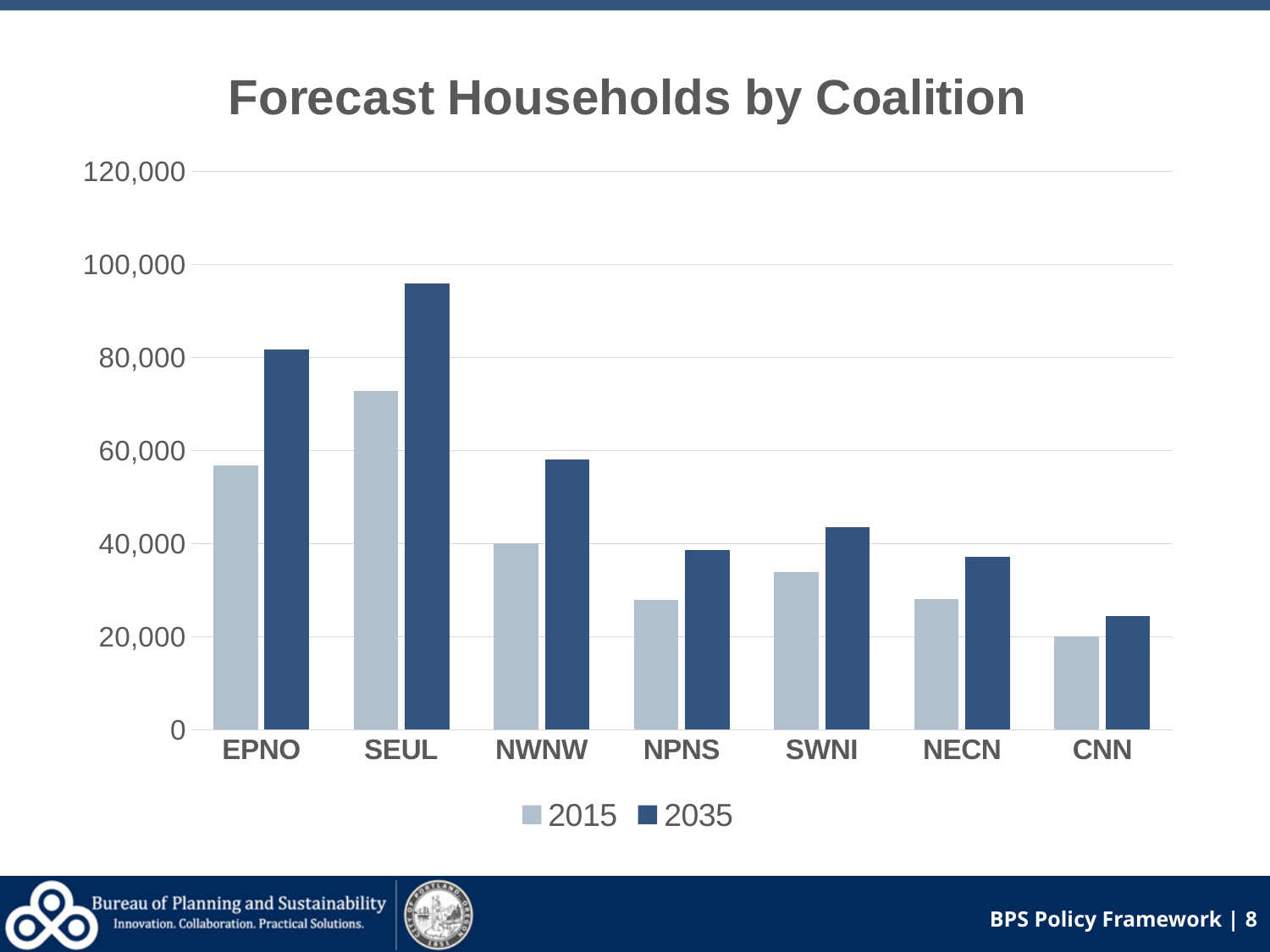
Is the 2015 value for NPNS greater or less than 40,000? less Is the 2035 value for SEUL greater or less than 80,000? greater How many coalitions are shown on the x axis? 7 Is the 2015 value for CNN greater or less than 40,000? less Which is larger, the 2035 value for EPNO or the 2035 value for NWNW? EPNO Which is larger, the 2015 value for SWNI or the 2015 value for NECN? SWNI Which coalition has the highest forecast households for 2035? SEUL What type of chart is shown on the slide? Bar chart What is the title of the chart? Forecast Households by Coalition Which coalition has the lowest households for 2015? CNN How many series does the legend list? 2